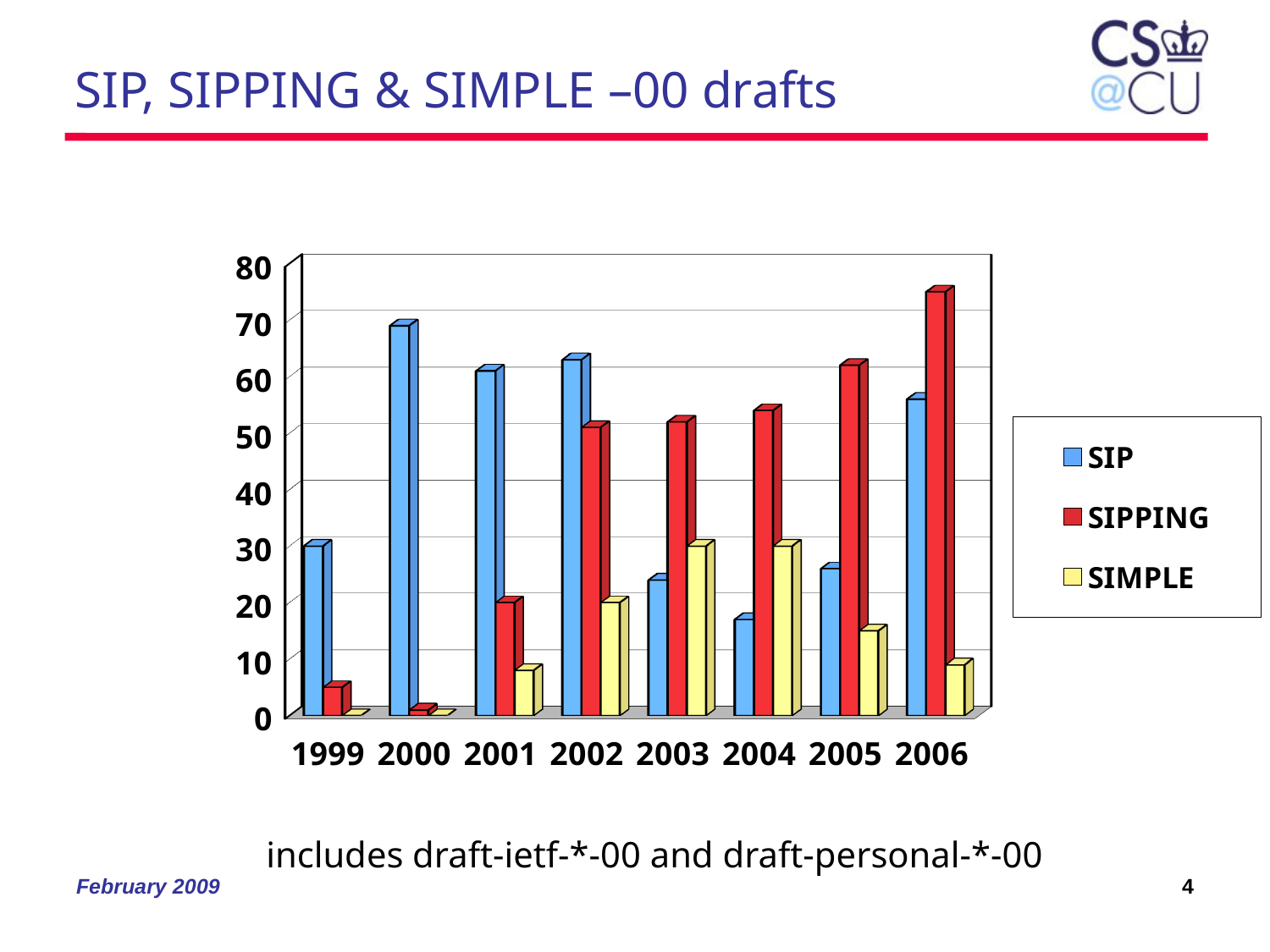
Is the SIPPING value for 1999 greater or less than 10? less Does the SIPPING series rise or fall from 2001 to 2006? rise In which year is the SIP value highest? 2000 Is the SIPPING value for 2006 greater or less than 60? greater In 2003, which is larger, SIP or SIPPING? SIPPING Is the SIP value for 2000 greater or less than 60? greater How many series does the legend list? 3 What kind of chart is shown on the slide? bar chart Which colour represents SIMPLE in the legend? yellow How many years are shown on the x axis? 8 In which year is the SIPPING value highest? 2006 In which year is the SIP value lowest? 2004